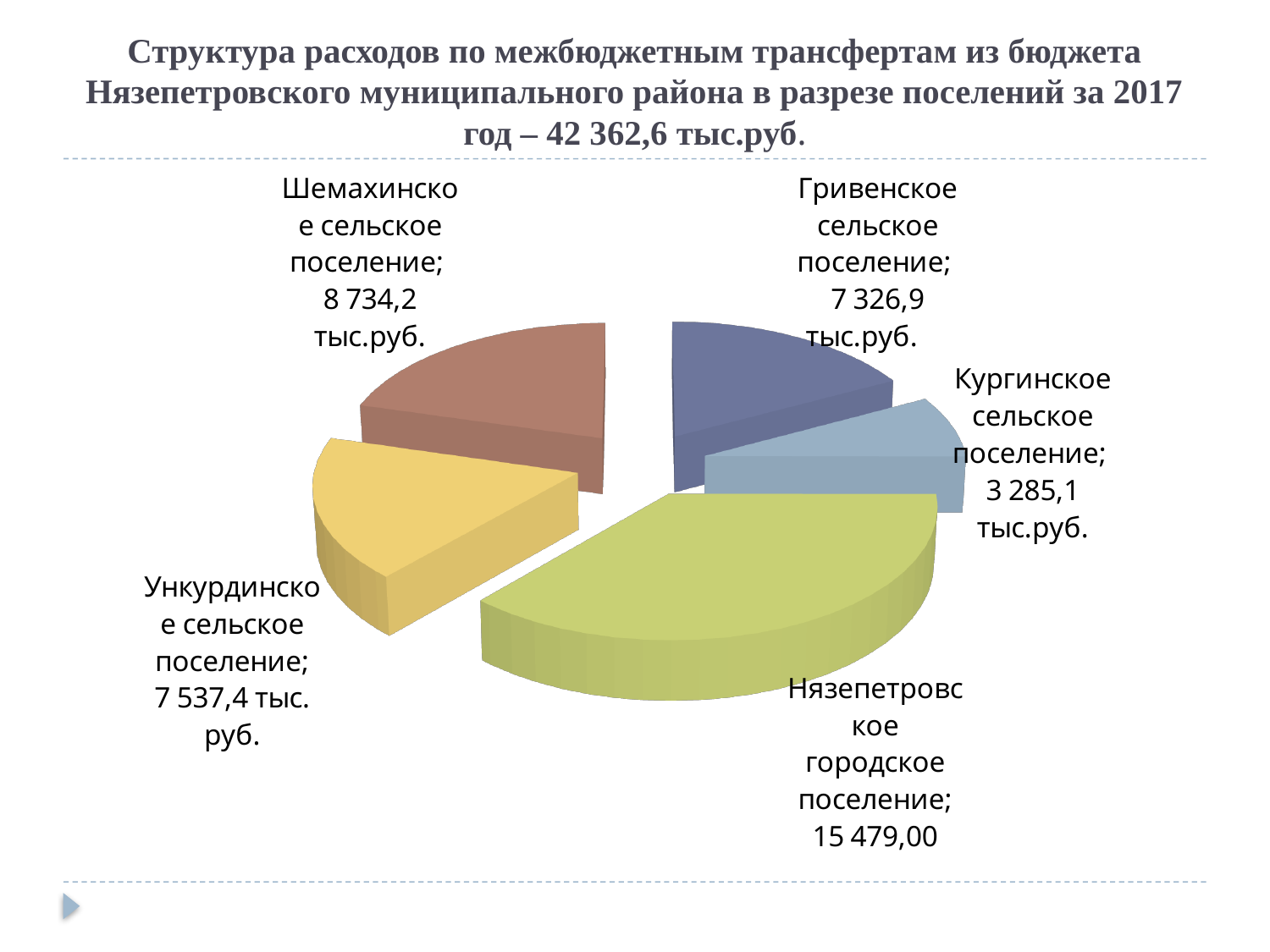
What kind of chart is shown on the slide? Pie chart What is the difference between the values for Шемахинское сельское поселение and Ункурдинское сельское поселение? 1 196,8 тыс.руб. What is the value for Гривенское сельское поселение? 7 326,9 тыс.руб. What is the value for Кургинское сельское поселение? 3 285,1 тыс.руб. Which is larger: the value for Ункурдинское сельское поселение or Гривенское сельское поселение? Ункурдинское сельское поселение According to the chart title, what is the total amount of intergovernmental transfer expenditures for 2017? 42 362,6 тыс.руб. Which settlement has the smallest share of intergovernmental transfer expenditures? Кургинское сельское поселение How many settlements (slices) are shown in the pie chart? 5 What is the value for Шемахинское сельское поселение? 8 734,2 тыс.руб. Which settlement has the largest share of intergovernmental transfer expenditures? Нязепетровское городское поселение What is the difference between the values for Нязепетровское городское поселение and Кургинское сельское поселение? 12 193,9 тыс.руб. What is the value for Нязепетровское городское поселение? 15 479,00